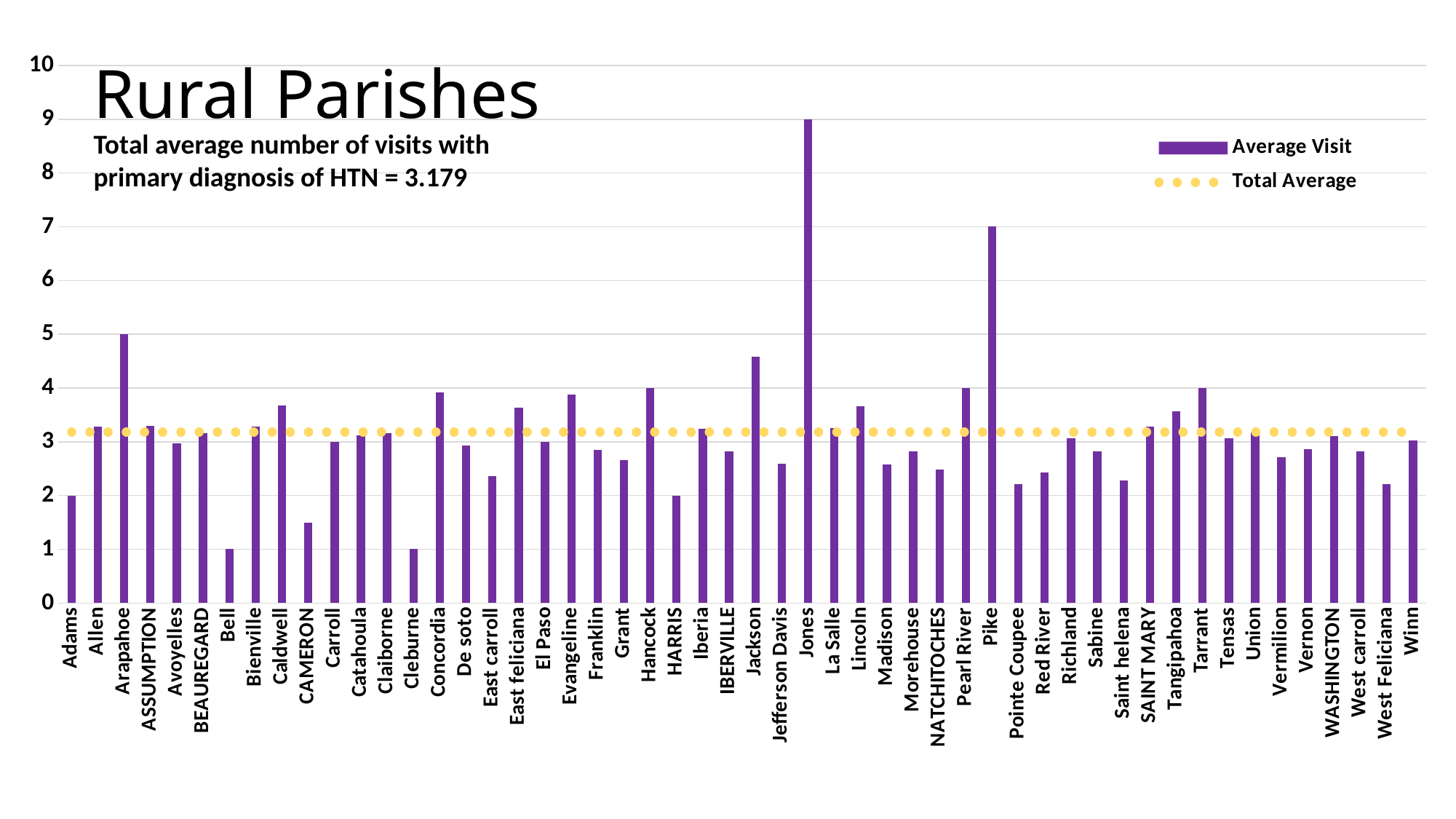
Which has a larger average visit value, Arapahoe or Jackson? Arapahoe What is the average visit value for Arapahoe? 5 What type of chart is shown on the slide? bar chart What is the average visit value for Pike? 7 Which parish has the highest average visit value? Jones What is the difference between the average visit values for Jones and Pike? 2 What is the title of the chart? Rural Parishes How many series does the legend list? 2 Is the average visit value for CAMERON greater or less than 2? less Is the average visit value for Jackson greater or less than 4? greater What is the total average number of visits with primary diagnosis of HTN stated on the slide? 3.179 What is the average visit value for Jones? 9